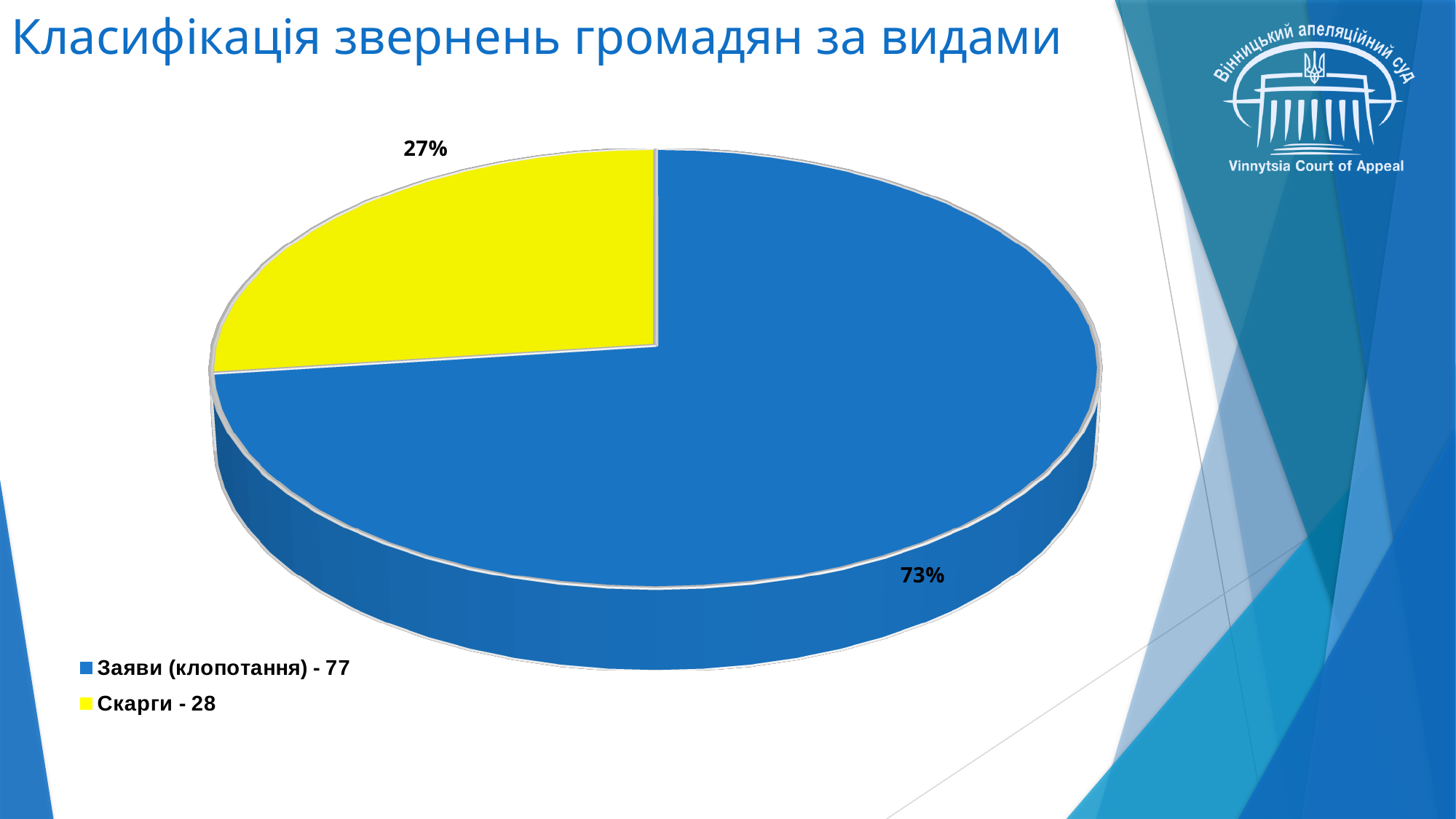
What percentage share does the slice for Заяви (клопотання) have? 73% What colour is the slice for Скарги? yellow What kind of chart is shown on the slide? pie chart How many slices does the pie chart have? 2 Which is larger, the share for Заяви (клопотання) or the share for Скарги? Заяви (клопотання) What count is given in the legend for Скарги? 28 Which category has the largest slice of the pie? Заяви (клопотання) Which category has the smallest slice of the pie? Скарги How many entries does the legend list? 2 What percentage share does the slice for Скарги have? 27% What is the difference in percentage points between the Заяви (клопотання) slice and the Скарги slice? 46% What count is given in the legend for Заяви (клопотання)? 77